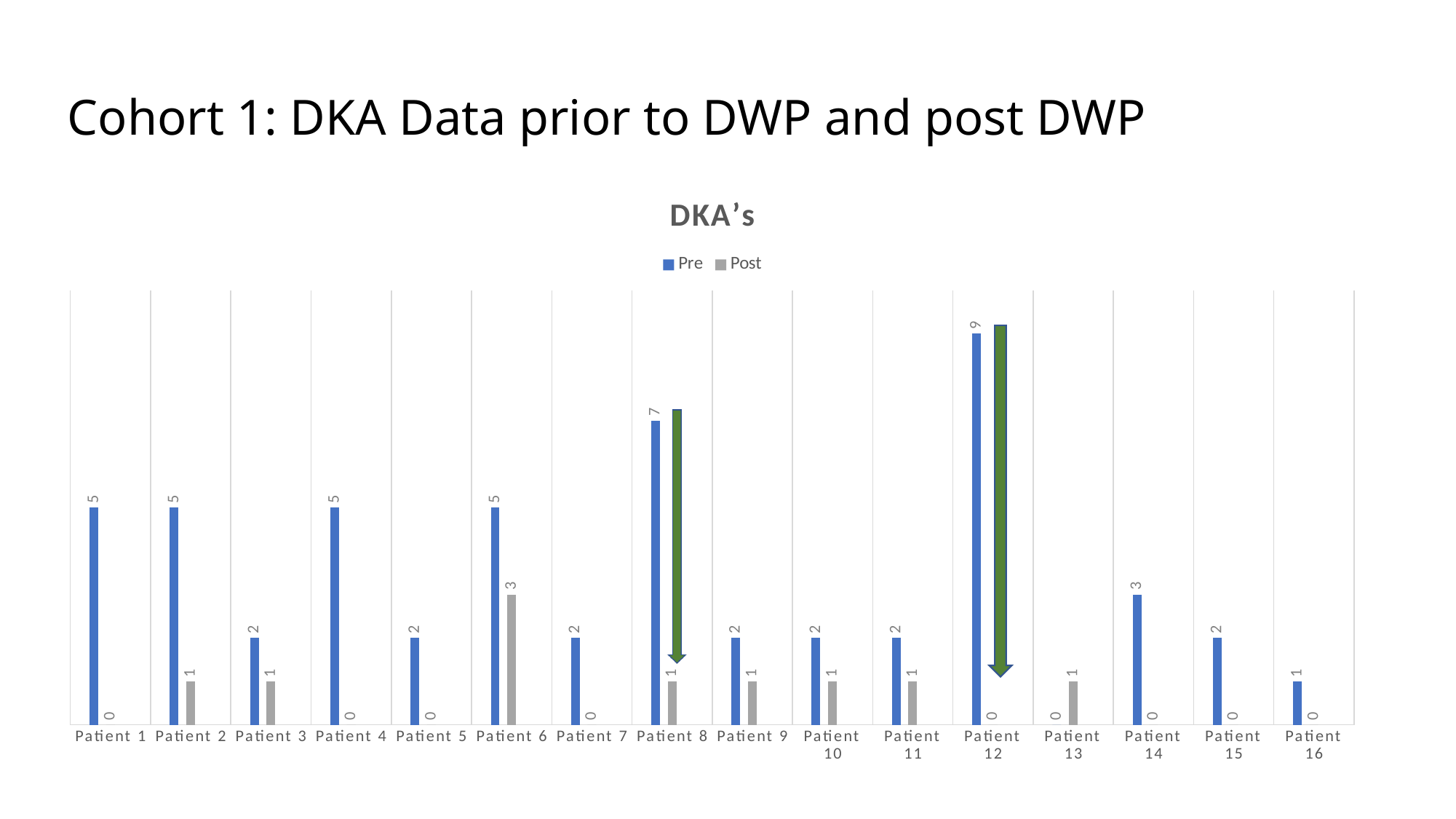
Which patient has the highest Post value? Patient 6 How many patients are shown on the x axis? 16 What is the difference between the Pre and Post values for Patient 8? 6 What is the Post value for Patient 13? 1 What is the title of the chart? DKA’s Which patient has the highest Pre value? Patient 12 What kind of chart is shown? Bar chart How many series does the legend list? 2 What is the Post value for Patient 6? 3 Which is larger for Patient 14, the Pre value or the Post value? Pre What is the Pre value for Patient 12? 9 What is the Pre value for Patient 8? 7